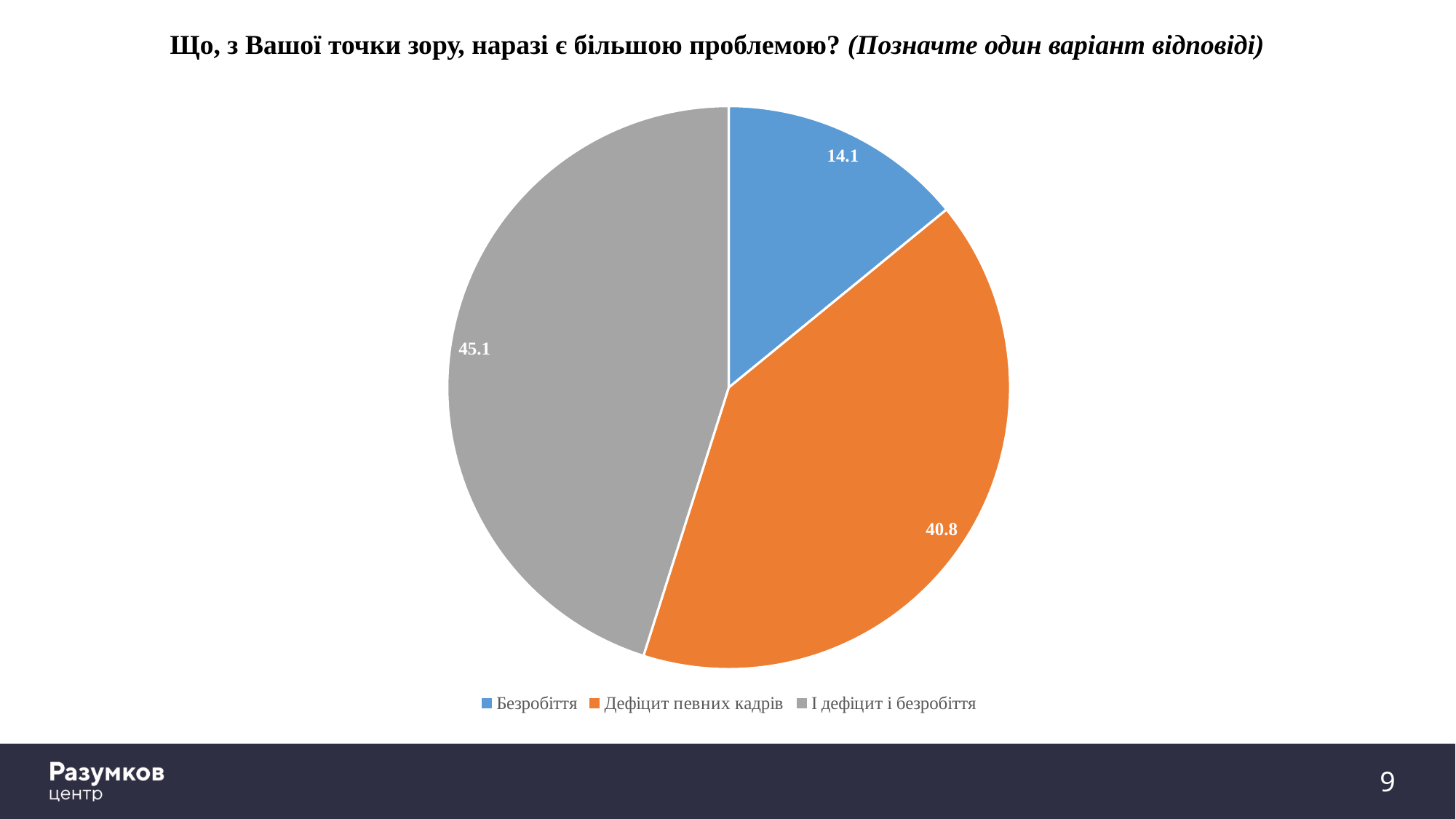
What colour is the slice for Дефіцит певних кадрів? orange How many entries does the legend list? 3 What is the value for І дефіцит і безробіття? 45.1 What type of chart is shown on the slide? pie chart Which category has the smallest slice? Безробіття What is the difference between the values for Дефіцит певних кадрів and Безробіття? 26.7 What is the difference between the values for І дефіцит і безробіття and Дефіцит певних кадрів? 4.3 Which is larger, the value for Безробіття or the value for Дефіцит певних кадрів? Дефіцит певних кадрів What is the value for Дефіцит певних кадрів? 40.8 Which category has the largest slice? І дефіцит і безробіття How many slices does the pie chart have? 3 What is the value for Безробіття? 14.1